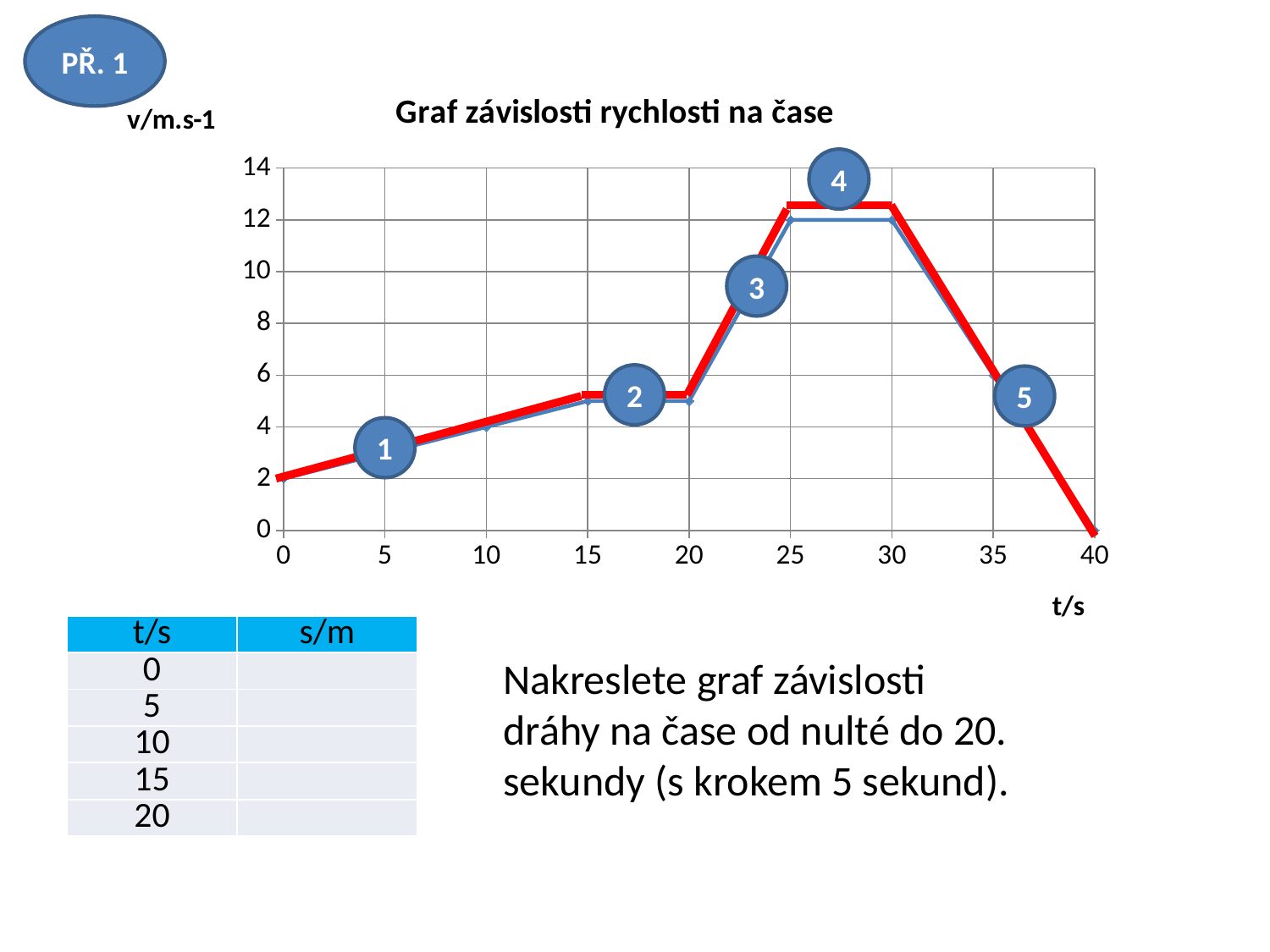
Is the value of v at t = 15 s greater or less than 4? greater What is the highest value of v reached on the chart? 12 What is the value of v at t = 0 s? 2 What is the value of v at t = 40 s? 0 What is the title of the chart? Graf závislosti rychlosti na čase What is the label of the horizontal axis of the chart? t/s What is the value of v at t = 10 s? 4 What kind of chart is shown on the slide? line chart Does v rise or fall between t = 30 s and t = 40 s? fall What is the difference between v at t = 25 s and v at t = 0 s? 10 At which value of t is v lowest? 40 What is the value of v at t = 25 s? 12